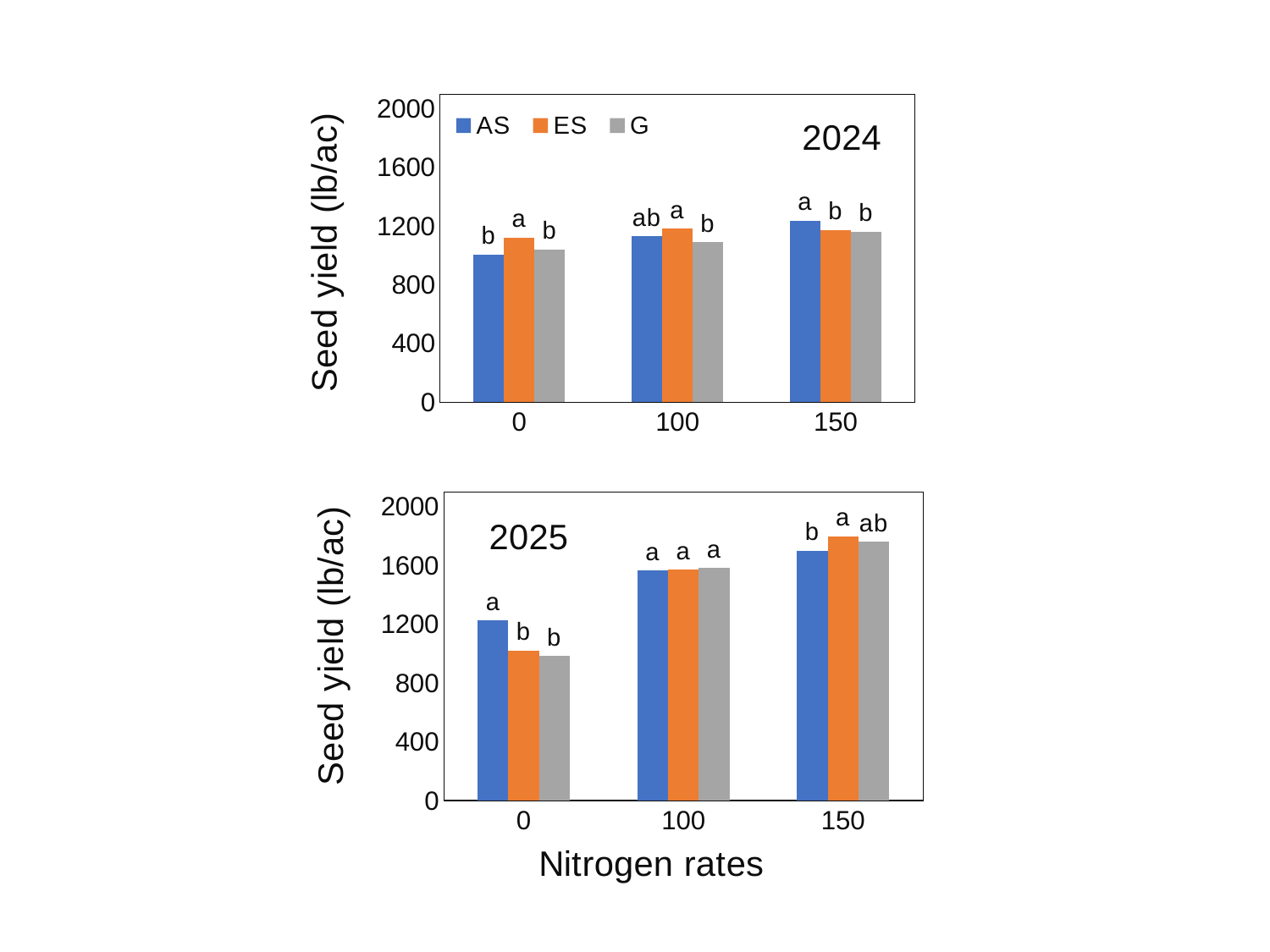
In the 2024 chart, which series has the lowest seed yield at nitrogen rate 0? AS What kind of chart is the top (2024) chart? bar chart In the 2025 chart, is the seed yield for ES at nitrogen rate 150 greater or less than 1600? greater In the 2025 chart, is the seed yield for ES at nitrogen rate 0 greater or less than 1200? less In the 2024 chart, is the seed yield for AS at nitrogen rate 150 greater or less than 1600? less What are the three legend entries on the 2024 chart? AS, ES, G In the 2025 chart, which series has the highest seed yield at nitrogen rate 0? AS In the 2025 chart, does the seed yield for AS rise or fall as the nitrogen rate increases from 0 to 150? rises In the 2024 chart, which series has the highest seed yield at nitrogen rate 150? AS How many series does the legend on the 2024 chart list? 3 How many nitrogen rates are shown on the x axis of the 2025 chart? 3 In the 2025 chart, at nitrogen rate 0, which is larger: the seed yield for AS or for ES? AS